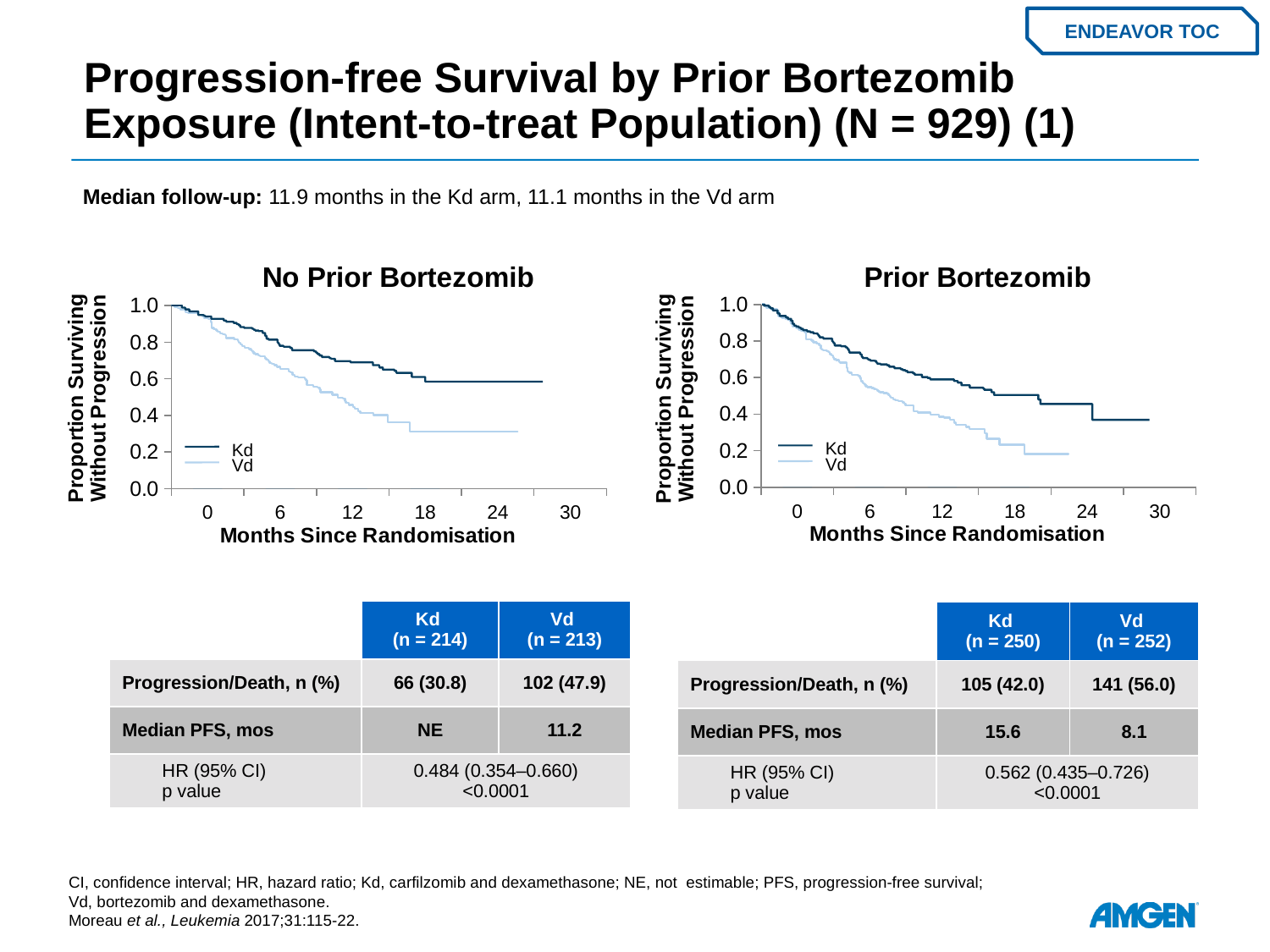
In the 'Prior Bortezomib' chart, is the Kd proportion surviving without progression at 12 months greater or less than 0.4? greater In the 'No Prior Bortezomib' chart, is the Vd proportion surviving without progression at 18 months greater or less than 0.4? less In the 'Prior Bortezomib' chart, which series has the higher proportion surviving without progression at 18 months, Kd or Vd? Kd In the 'No Prior Bortezomib' chart, is the Kd proportion surviving without progression at 12 months greater or less than 0.6? greater In the 'No Prior Bortezomib' chart, which two series are listed in the legend? Kd and Vd How many series does the legend of the 'Prior Bortezomib' chart list? 2 In the 'Prior Bortezomib' chart, do the curves rise or fall along the x axis? fall In the 'No Prior Bortezomib' chart, do the Kd and Vd curves rise or fall as months since randomisation increase? fall What is the x-axis label of the 'Prior Bortezomib' chart? Months Since Randomisation What kind of chart is the 'No Prior Bortezomib' chart? line chart In the 'No Prior Bortezomib' chart, which series has the lower proportion surviving without progression at 24 months, Kd or Vd? Vd